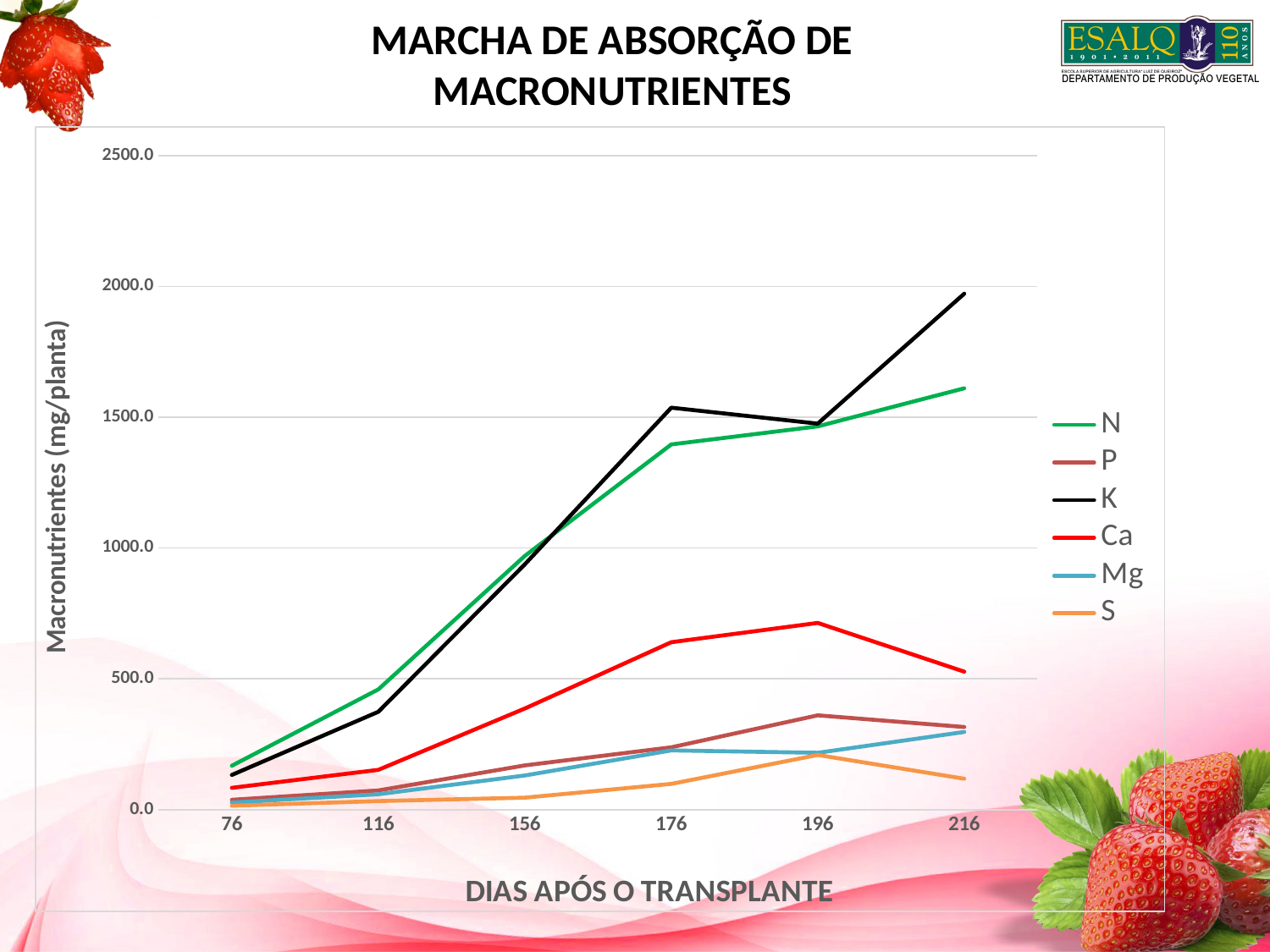
How many series does the legend list? 6 What is the title of the chart? MARCHA DE ABSORÇÃO DE MACRONUTRIENTES Which series has the highest value at 216 days after transplant? K Is the value for Ca at 196 days greater or less than 500? greater What kind of chart is shown on the slide? line chart Is the value for N at 116 days greater or less than 500? less What is the label of the y axis? Macronutrientes (mg/planta) Does the value for Ca rise or fall between 196 and 216 days? fall At 196 days, which is larger: the value for Ca or the value for P? Ca How many points are shown along the x axis (days after transplant)? 6 Which series has the lowest value at 216 days after transplant? S Is the value for K at 216 days greater or less than 1500? greater